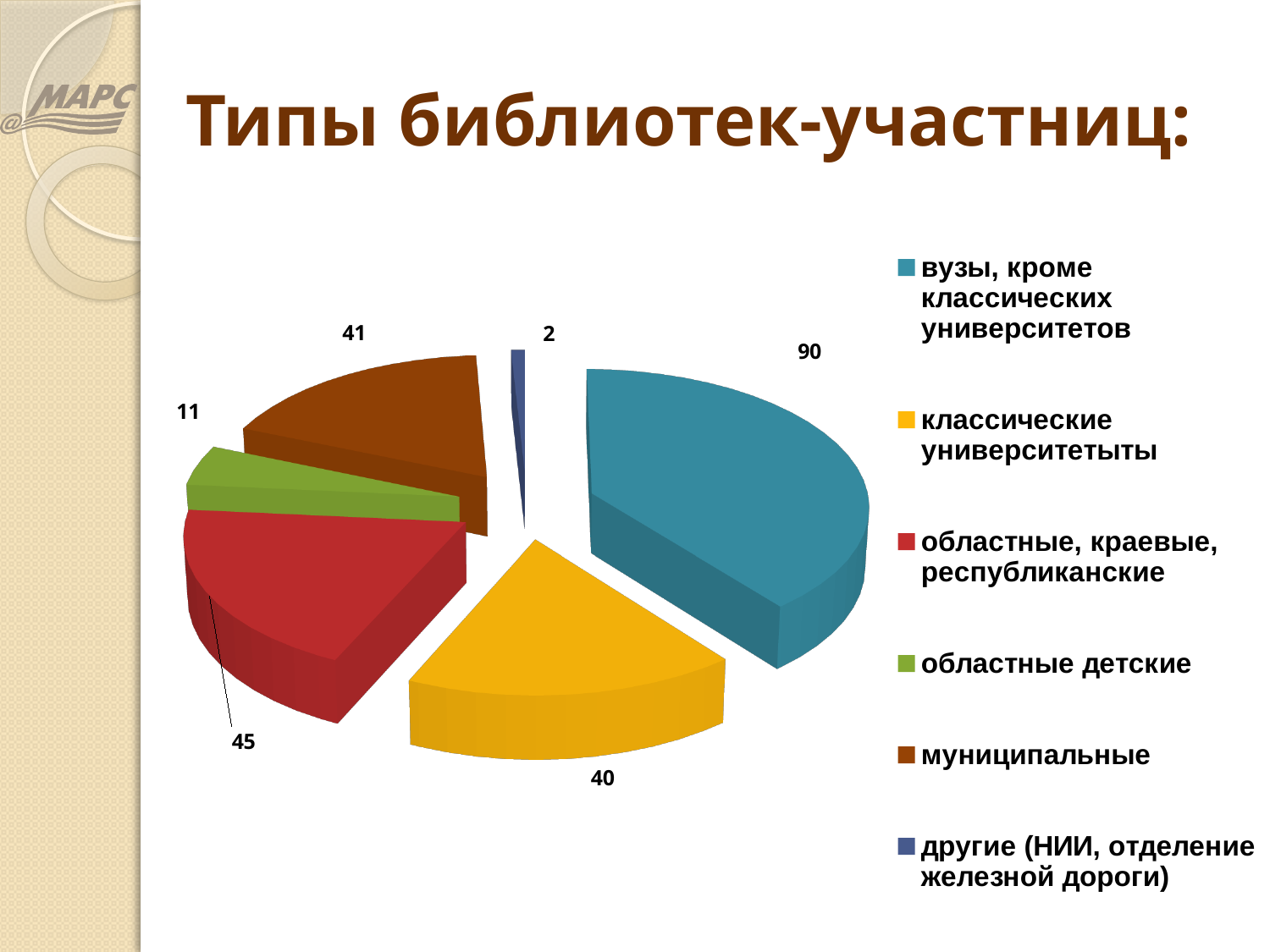
What is the value for 'областные, краевые, республиканские'? 45 What is the difference between the values for 'вузы, кроме классических университетов' and 'классические университетыты'? 50 What is the title of the chart on the slide? Типы библиотек-участниц: What is the value for 'муниципальные'? 41 What is the value for 'вузы, кроме классических университетов'? 90 How many categories does the legend list? 6 What is the value for 'областные детские'? 11 What is the value for 'классические университетыты'? 40 Which category has the smallest slice of the pie? другие (НИИ, отделение железной дороги) Which category has the largest slice of the pie? вузы, кроме классических университетов What type of chart is shown on the slide? pie chart What is the value for 'другие (НИИ, отделение железной дороги)'? 2